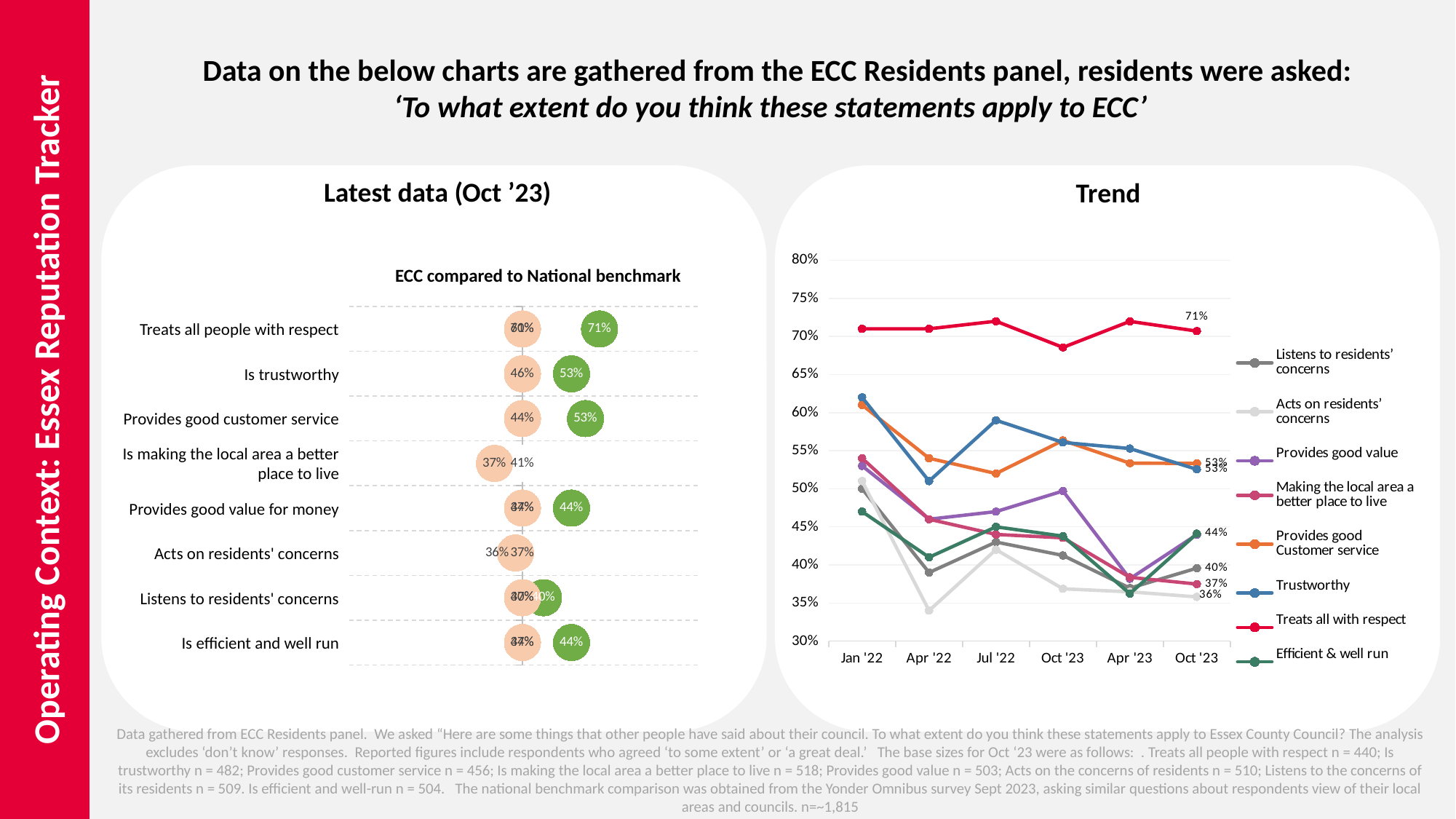
In the Trend chart, does the 'Acts on residents' concerns' line rise or fall from Jan '22 to the final Oct '23 point? fall In the Trend chart, what is the value for 'Treats all with respect' at the final Oct '23 point? 71% How many statements are listed in the 'ECC compared to National benchmark' chart? 8 In the Trend chart, is the value for 'Acts on residents' concerns' at Apr '22 greater or less than 40%? less In the 'ECC compared to National benchmark' chart, what is the green value for 'Is trustworthy'? 53% In the 'ECC compared to National benchmark' chart, which is larger for 'Provides good customer service': the green value or the orange value? The green value (53%) How many series does the legend of the Trend chart list? 8 How many time points are shown on the x axis of the Trend chart? 6 What kind of chart is the Trend chart on the right? Line chart In the 'ECC compared to National benchmark' chart, what is the difference between the green (53%) and orange (46%) values for 'Is trustworthy'? 7 percentage points In the Trend chart, which series has the highest value at the final Oct '23 point? Treats all with respect In the Trend chart, is the value for 'Treats all with respect' at Jan '22 greater or less than 65%? greater